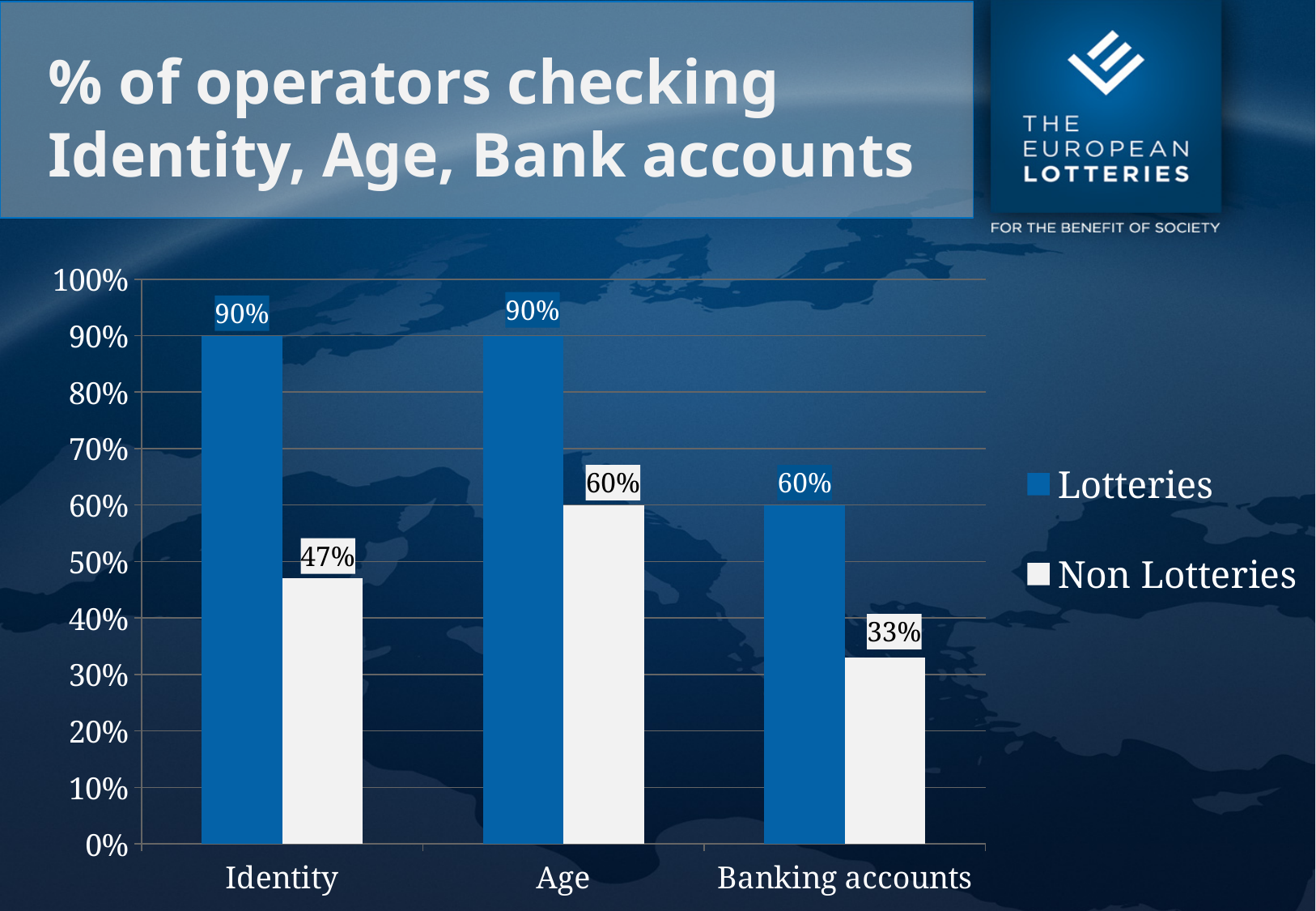
How many categories are shown on the x axis? 3 For which category is the Non Lotteries value lowest? Banking accounts What is the difference between the Lotteries and Non Lotteries values for Banking accounts? 27% Which is larger for Age: the Lotteries value or the Non Lotteries value? Lotteries What is the difference between the Lotteries and Non Lotteries values for Identity? 43% What percentage of Lotteries check Identity? 90% What percentage of Non Lotteries check Age? 60% How many series does the legend list? 2 What percentage of Non Lotteries check Banking accounts? 33% What percentage of Lotteries check Banking accounts? 60% For which category is the Non Lotteries value highest? Age What kind of chart is shown on the slide? Bar chart